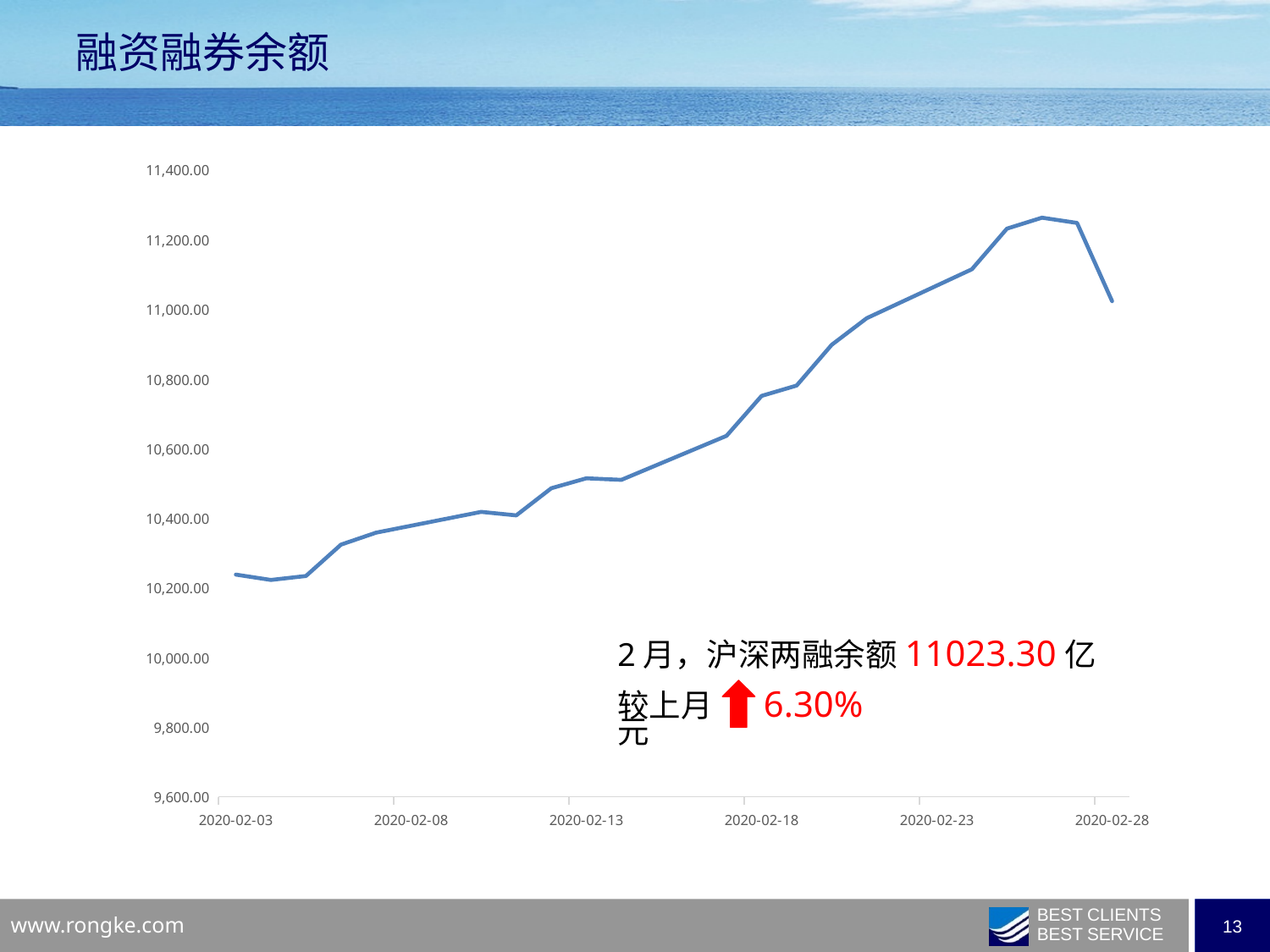
Overall, do the values rise or fall from 2020-02-03 to 2020-02-28? rise Is the value for 2020-02-03 greater or less than 10,200.00? greater Which is larger, the value for 2020-02-28 or the value for 2020-02-03? 2020-02-28 According to the text on the slide, by what percentage did the February 沪深两融余额 change compared with the previous month? 6.30% Is the value for 2020-02-13 greater or less than 10,400.00? greater Is the value for 2020-02-18 greater or less than 10,600.00? greater Among the dates labeled on the x axis, which has the lowest value? 2020-02-03 What is the title of the slide's chart? 融资融券余额 What kind of chart is shown on the slide? line chart